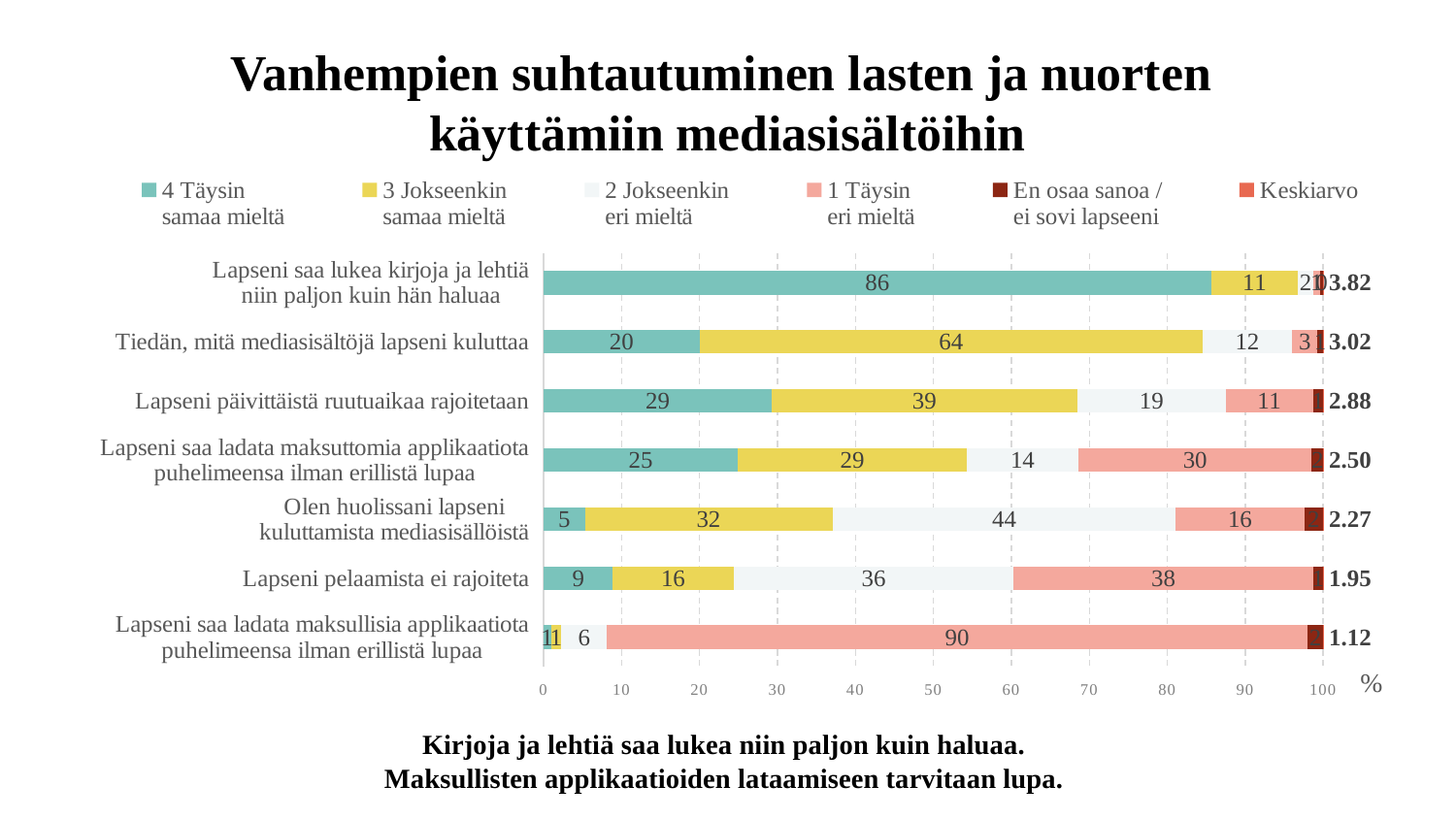
What is the "3 Jokseenkin samaa mieltä" value for "Tiedän, mitä mediasisältöjä lapseni kuluttaa"? 64 How many statements (categories) are plotted in the chart? 7 What is the difference between the "2 Jokseenkin eri mieltä" value for "Olen huolissani lapseni kuluttamista mediasisällöistä" (44) and for "Lapseni pelaamista ei rajoiteta" (36)? 8 What kind of chart is shown on the slide? stacked bar chart What percentage of parents answered "4 Täysin samaa mieltä" to "Lapseni saa lukea kirjoja ja lehtiä niin paljon kuin hän haluaa"? 86 What is the Keskiarvo value for "Lapseni päivittäistä ruutuaikaa rajoitetaan"? 2.88 Which statement has the lowest Keskiarvo value? Lapseni saa ladata maksullisia applikaatiota puhelimeensa ilman erillistä lupaa Which is larger: the "1 Täysin eri mieltä" value for "Lapseni pelaamista ei rajoiteta" or for "Lapseni saa ladata maksuttomia applikaatiota puhelimeensa ilman erillistä lupaa"? Lapseni pelaamista ei rajoiteta Which statement has the highest "4 Täysin samaa mieltä" share? Lapseni saa lukea kirjoja ja lehtiä niin paljon kuin hän haluaa What is the Keskiarvo value for "Lapseni pelaamista ei rajoiteta"? 1.95 How many series does the legend list? 6 What percentage answered "1 Täysin eri mieltä" to "Lapseni saa ladata maksullisia applikaatiota puhelimeensa ilman erillistä lupaa"? 90